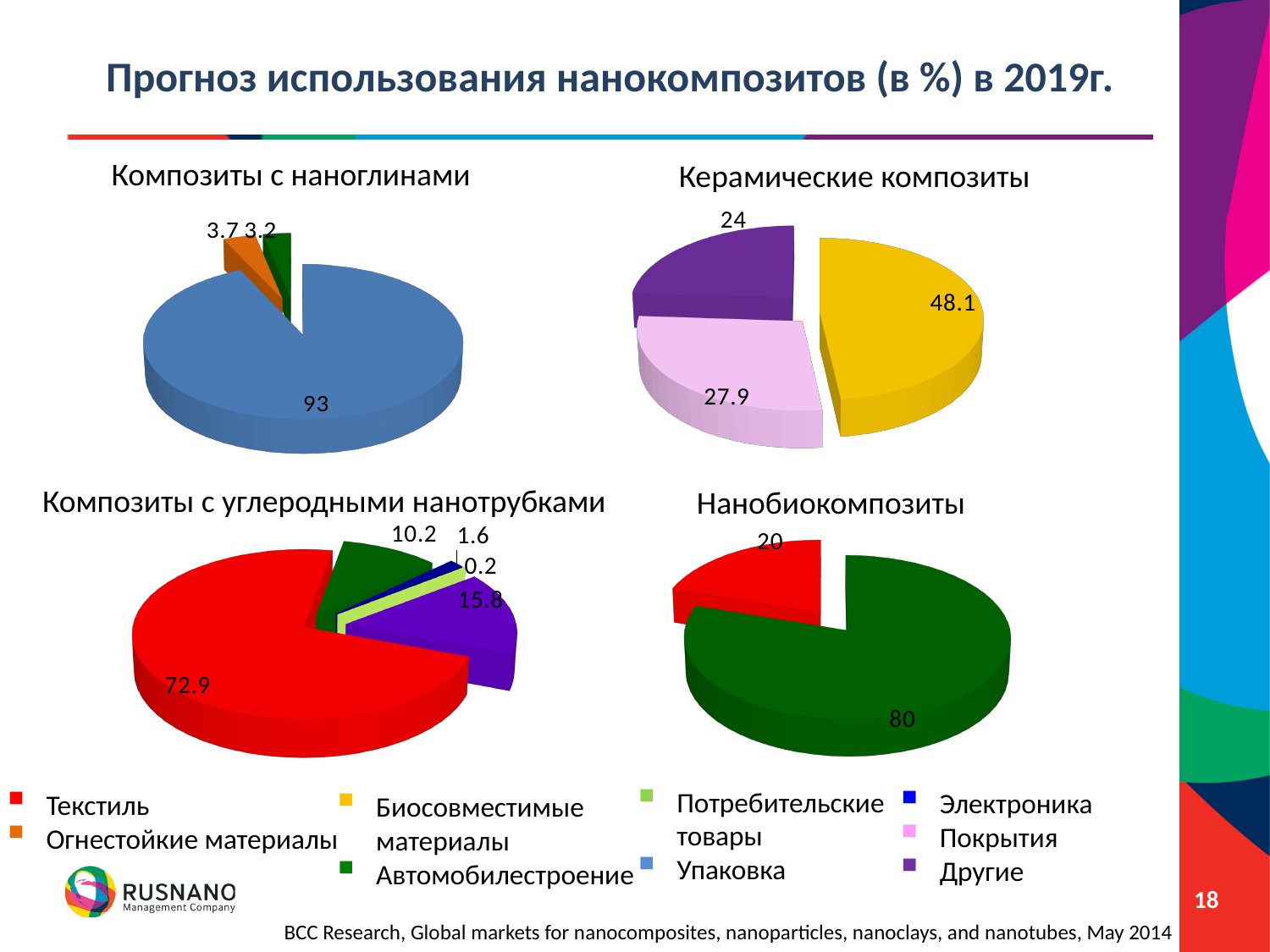
How many slices does the 'Нанобиокомпозиты' chart have? 2 In the 'Композиты с углеродными нанотрубками' chart, what value is shown for Текстиль? 72.9 In the 'Керамические композиты' chart, what is the difference between the values for Биосовместимые материалы and Другие? 24.1 In the 'Композиты с углеродными нанотрубками' chart, what is the smallest value labelled? 0.2 In the 'Композиты с наноглинами' chart, what value is shown for the largest slice (Упаковка)? 93 In the 'Нанобиокомпозиты' chart, what value is shown for Автомобилестроение? 80 In the 'Керамические композиты' chart, which category has the smallest slice? Другие In the 'Композиты с наноглинами' chart, what value is shown for Огнестойкие материалы? 3.7 In the 'Керамические композиты' chart, what value is shown for Биосовместимые материалы? 48.1 In the 'Композиты с углеродными нанотрубками' chart, which is larger: Другие or Автомобилестроение? Другие What type of chart is used for 'Керамические композиты'? Pie chart In the 'Керамические композиты' chart, what value is shown for Покрытия? 27.9